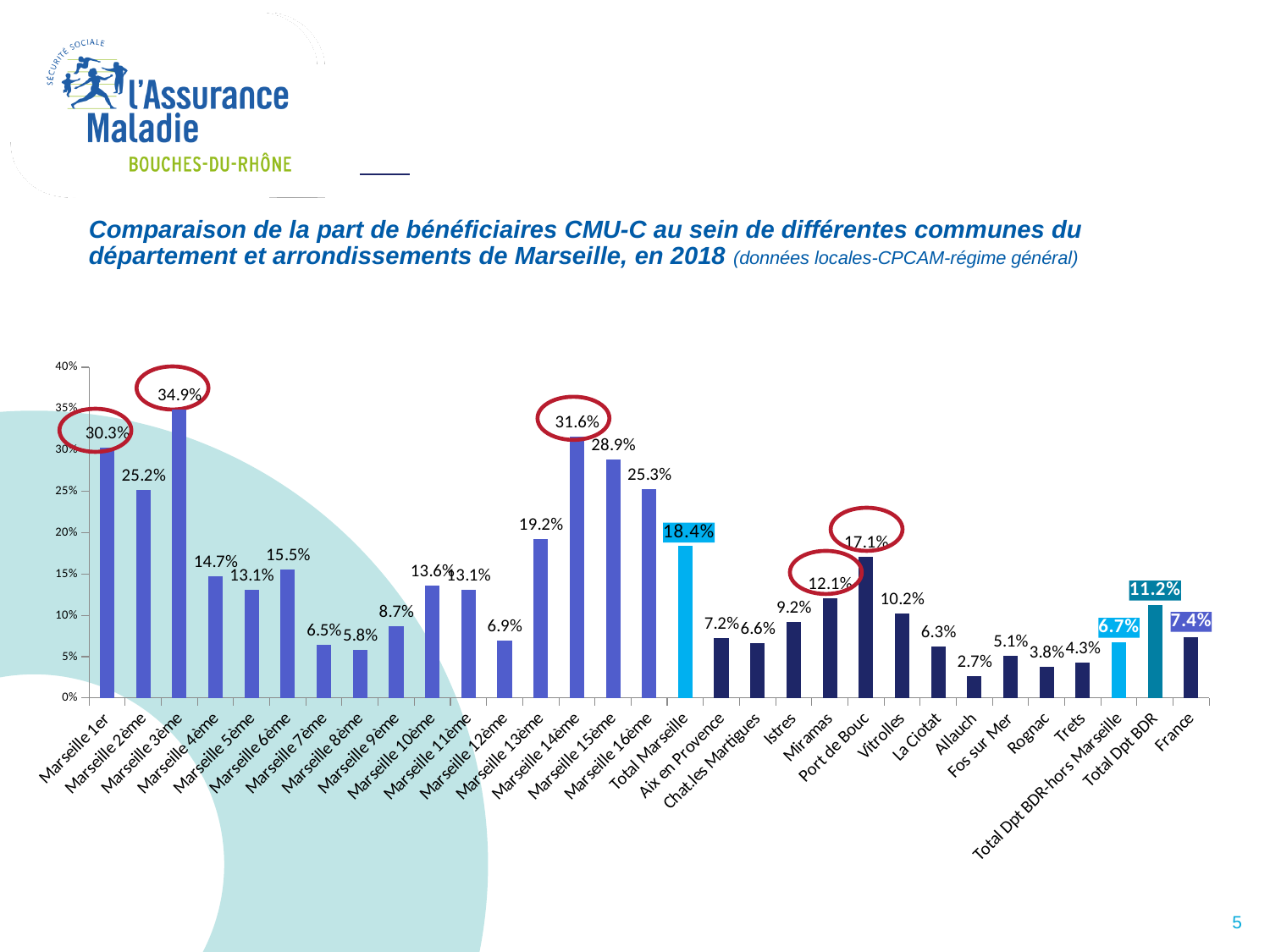
What type of chart is shown on the slide? Bar chart Which is larger, the value for Miramas or the value for Vitrolles? Miramas How many bars are plotted in the chart? 31 Is the value for Marseille 13ème greater or less than 15%? greater What is the value shown for Marseille 3ème? 34.9% Which category has the lowest value in the chart? Allauch What is the value shown for Port de Bouc? 17.1% What is the difference between the values for Marseille 14ème and Marseille 15ème? 2.7% What is the value shown for France? 7.4% What is the difference between the values for Total Dpt BDR and Total Dpt BDR-hors Marseille? 4.5% What is the value shown for Total Marseille? 18.4% Which category has the highest value in the chart? Marseille 3ème